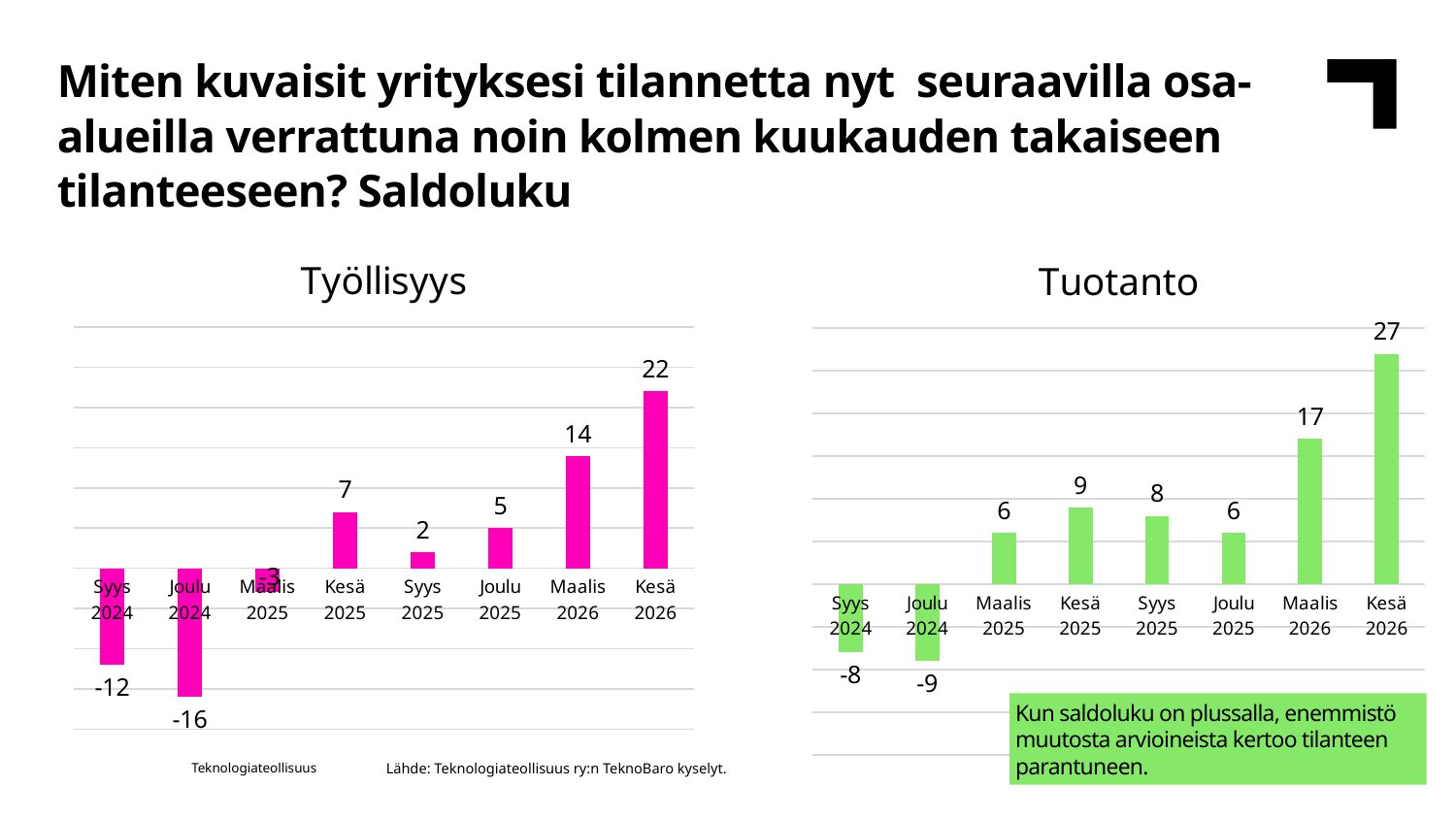
In the Tuotanto chart, what is the value for Maalis 2026? 17 What kind of chart is the Tuotanto chart? Bar chart In the Tuotanto chart, what is the difference between the values for Kesä 2026 and Kesä 2025? 18 In the Työllisyys chart, which period has the lowest value? Joulu 2024 In the Tuotanto chart, what is the value for Syys 2024? -8 In the Tuotanto chart, which is larger, the value for Kesä 2025 or the value for Syys 2025? Kesä 2025 In the Työllisyys chart, what is the value for Joulu 2024? -16 In the Tuotanto chart, which period has the highest value? Kesä 2026 How many periods are shown on the x axis of the Työllisyys chart? 8 In the Tuotanto chart, do the values generally rise or fall from Syys 2024 to Kesä 2026? Rise In the Työllisyys chart, what is the value for Kesä 2026? 22 In the Työllisyys chart, what is the difference between the values for Kesä 2026 and Maalis 2026? 8